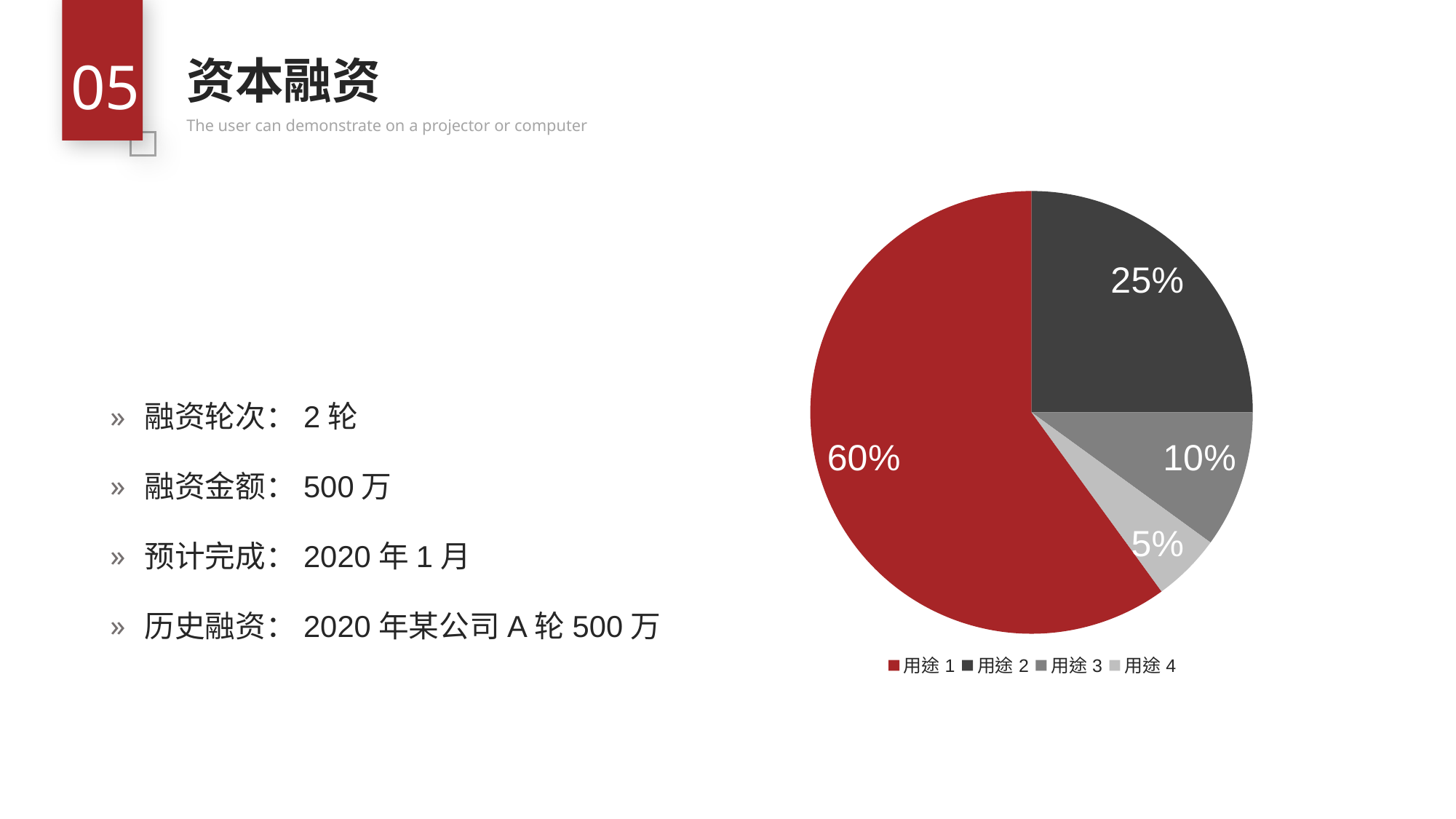
What share of the pie does 用途 1 have? 60% Which is larger, the share of 用途 3 or the share of 用途 4? 用途 3 What share of the pie does 用途 4 have? 5% What is the difference between the shares of 用途 1 and 用途 2? 35% What colour is the slice for 用途 1? red Which category has the smallest slice of the pie? 用途 4 How many slices does the pie chart have? 4 How many entries does the legend list? 4 What share of the pie does 用途 3 have? 10% What kind of chart is shown on the slide? pie chart Which category has the largest slice of the pie? 用途 1